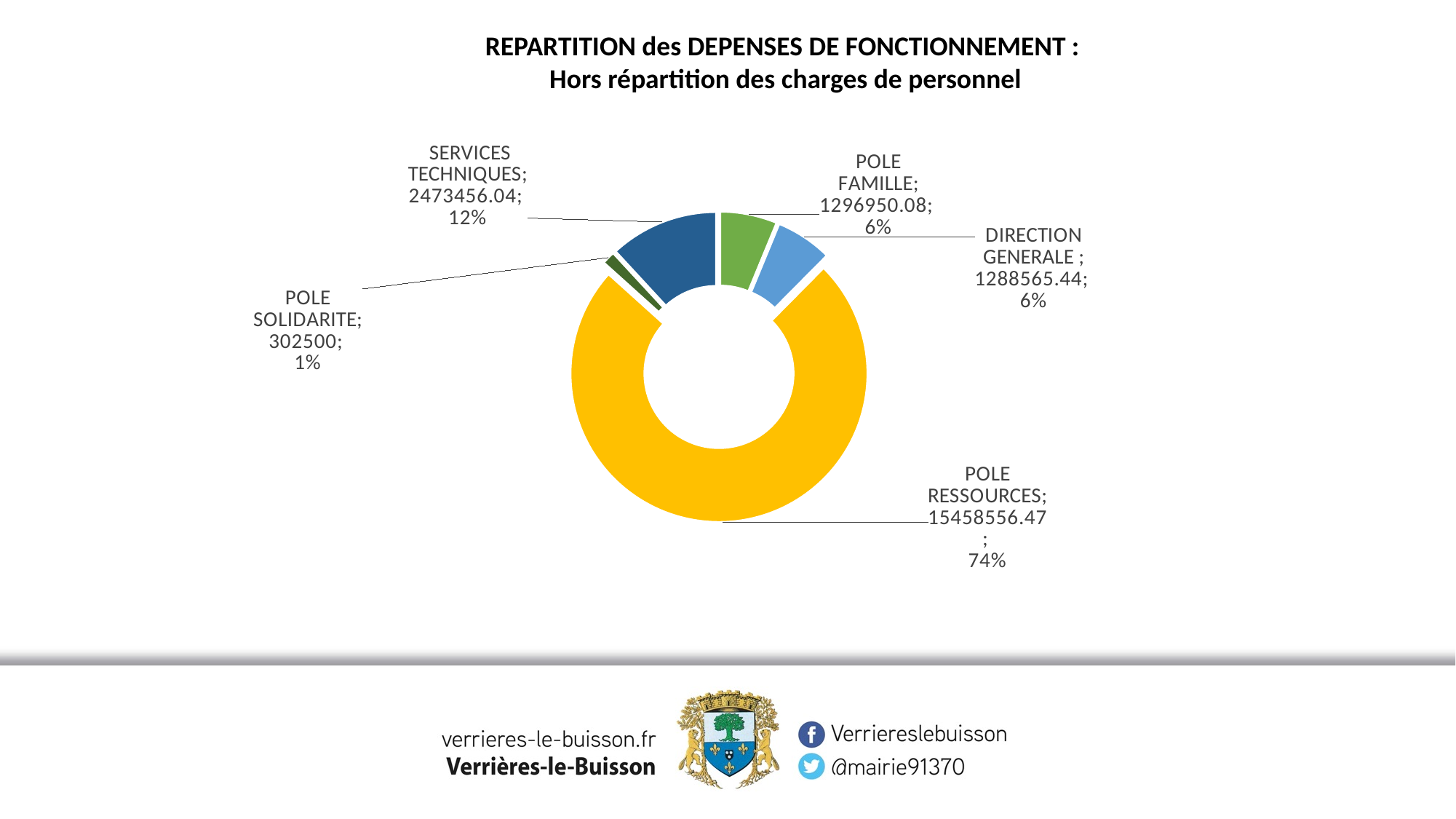
What is the difference between the values for SERVICES TECHNIQUES and POLE FAMILLE? 1176505.96 What percentage share does SERVICES TECHNIQUES have? 12% Which is larger, the value for POLE FAMILLE or for DIRECTION GENERALE? POLE FAMILLE What value is shown for POLE SOLIDARITE? 302500 What percentage share does POLE RESSOURCES have? 74% How many categories are shown in the chart? 5 What value is shown for POLE RESSOURCES? 15458556.47 Which category has the smallest share? POLE SOLIDARITE Which category has the largest share? POLE RESSOURCES What colour is the POLE RESSOURCES slice? yellow What kind of chart is shown? doughnut chart What value is shown for DIRECTION GENERALE? 1288565.44